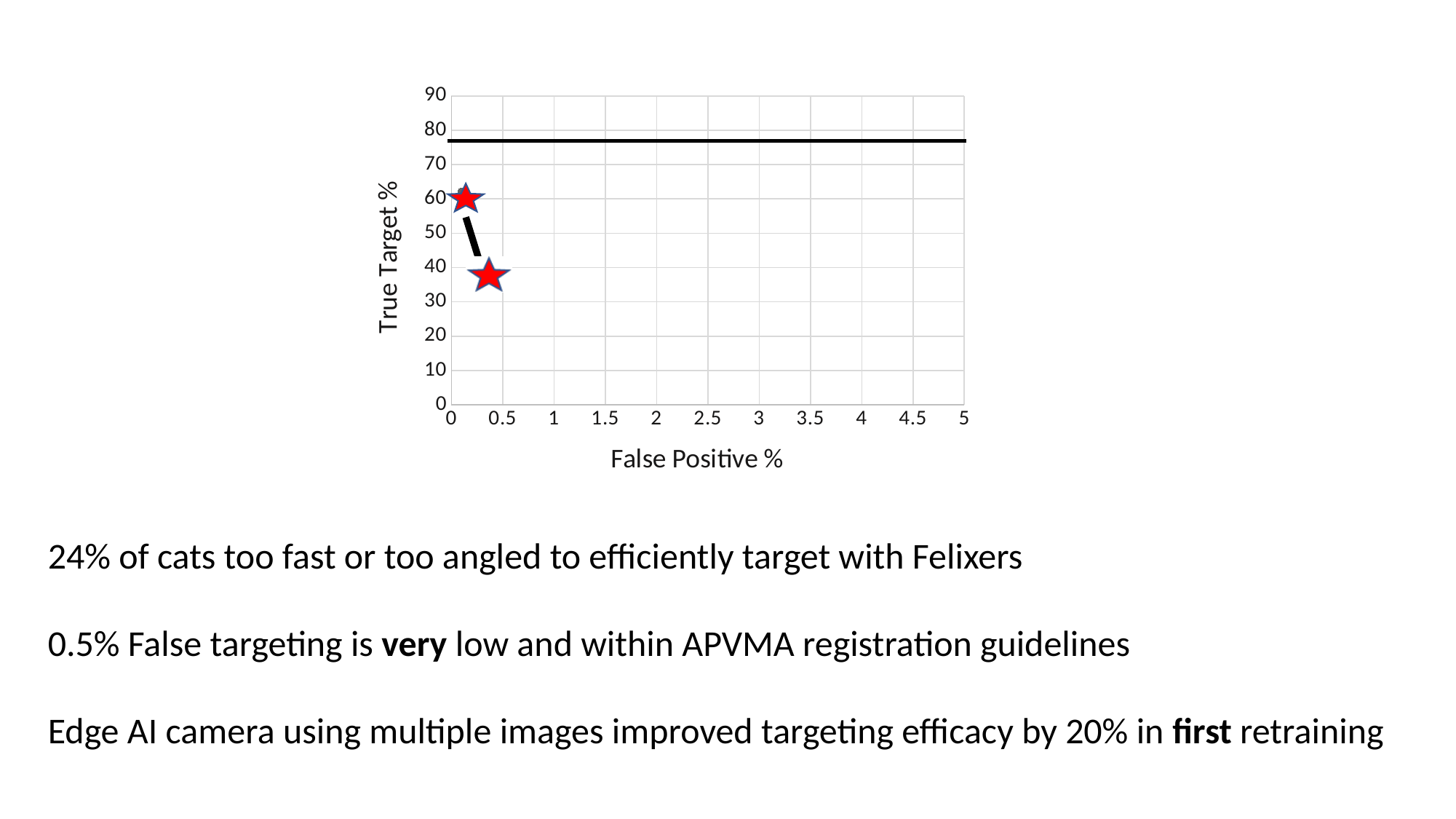
Is the horizontal black line on the chart greater or less than 80 on the True Target % axis? less What is the label of the x axis of the chart? False Positive % Do both star markers lie below the horizontal black line? yes What is the label of the y axis of the chart? True Target % Is the True Target % of the upper star marker greater or less than 50? greater Which star marker has the higher True Target %: the one closer to the y axis or the one further right? the one closer to the y axis Is the True Target % of the lower star marker greater or less than 50? less How many star markers are plotted on the chart? 2 What kind of chart is shown on the slide? scatter chart Moving from the left star marker to the right star marker, does True Target % rise or fall? fall